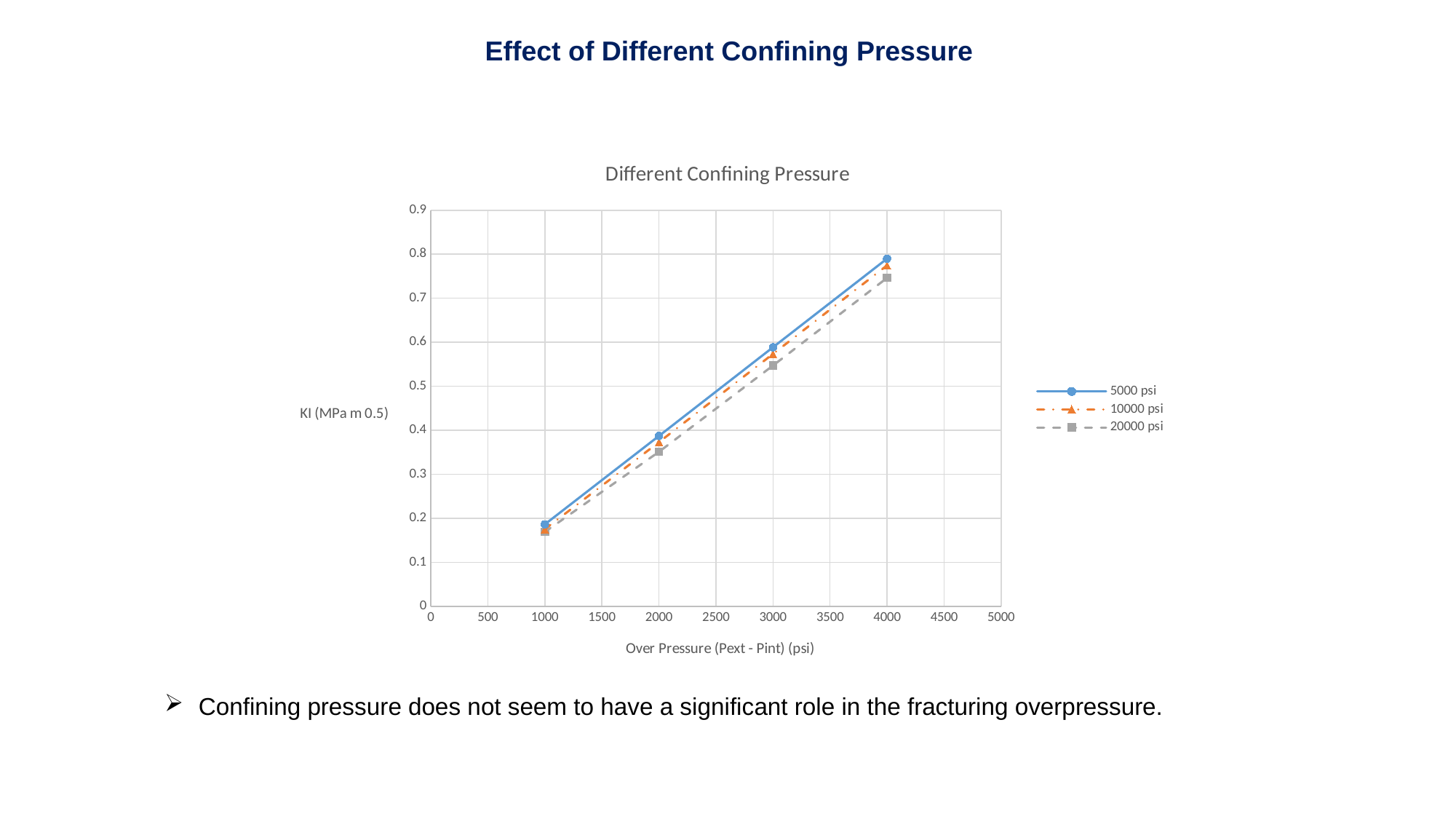
What is the title of the chart? Different Confining Pressure What is the label of the x axis? Over Pressure (Pext - Pint) (psi) Is the KI value for the 20000 psi series at 2000 psi over pressure greater or less than 0.4? less How many series does the legend list? 3 Is the KI value for the 5000 psi series at 1000 psi over pressure greater or less than 0.3? less What kind of chart is shown on the slide? line chart Is the KI value for the 10000 psi series at 3000 psi over pressure greater or less than 0.5? greater How many data points are plotted for the 5000 psi series? 4 Do the KI values rise or fall as over pressure increases along the x axis? rise At an over pressure of 4000 psi, which series has the larger KI value, 5000 psi or 20000 psi? 5000 psi Which series has the lowest KI value at an over pressure of 4000 psi? 20000 psi